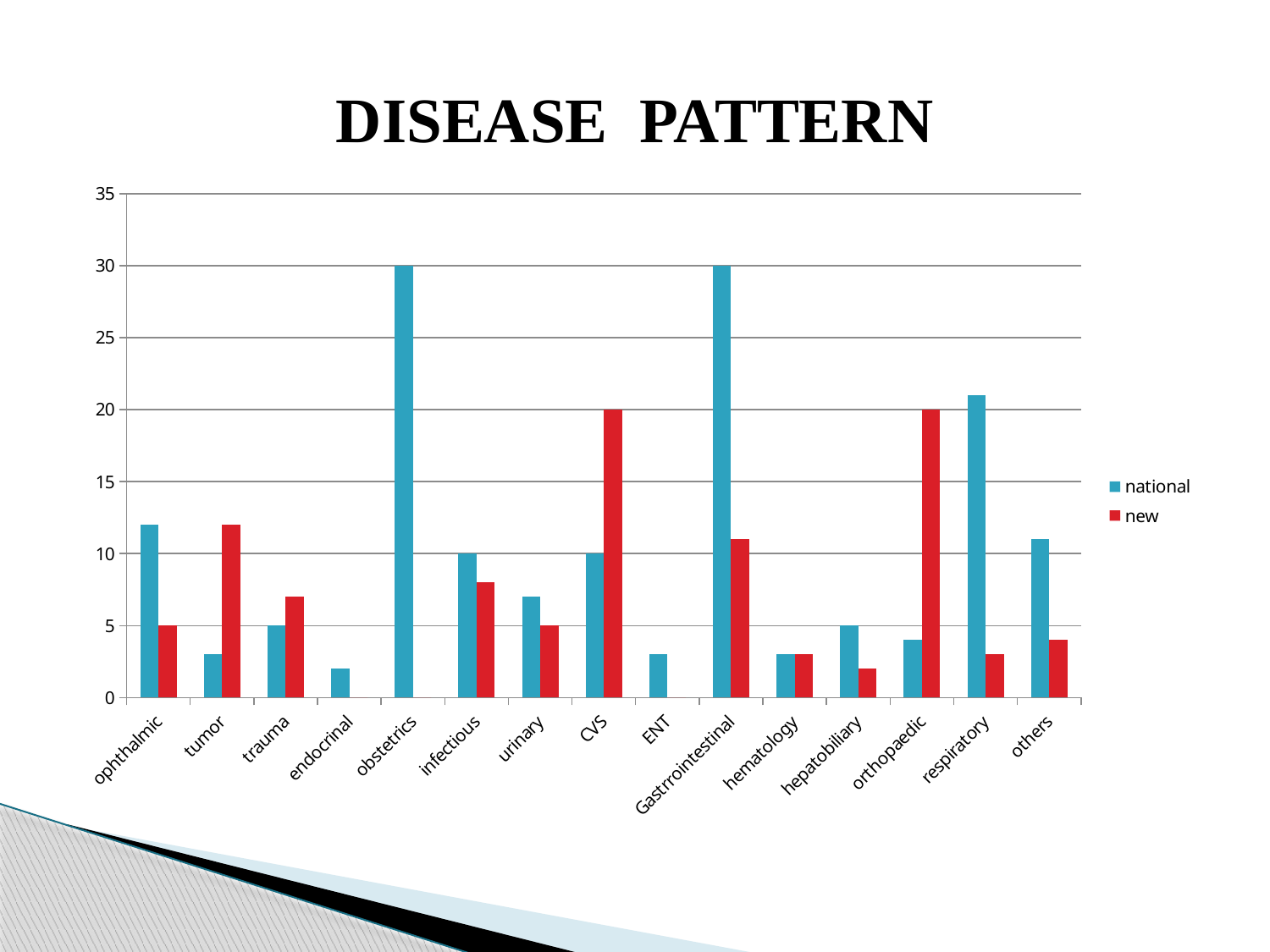
How many disease categories are shown on the x axis? 15 Is the national value for endocrinal greater or less than 5? less What is the new value for CVS? 20 What is the national value for infectious? 10 How many series does the legend list? 2 Which is larger for ophthalmic, the national value or the new value? national What kind of chart is shown on the slide? bar chart Which is larger for tumor, the national value or the new value? new What is the national value for obstetrics? 30 What is the difference between the national value for obstetrics and the national value for CVS? 20 Is the national value for respiratory greater or less than 20? greater What is the new value for orthopaedic? 20